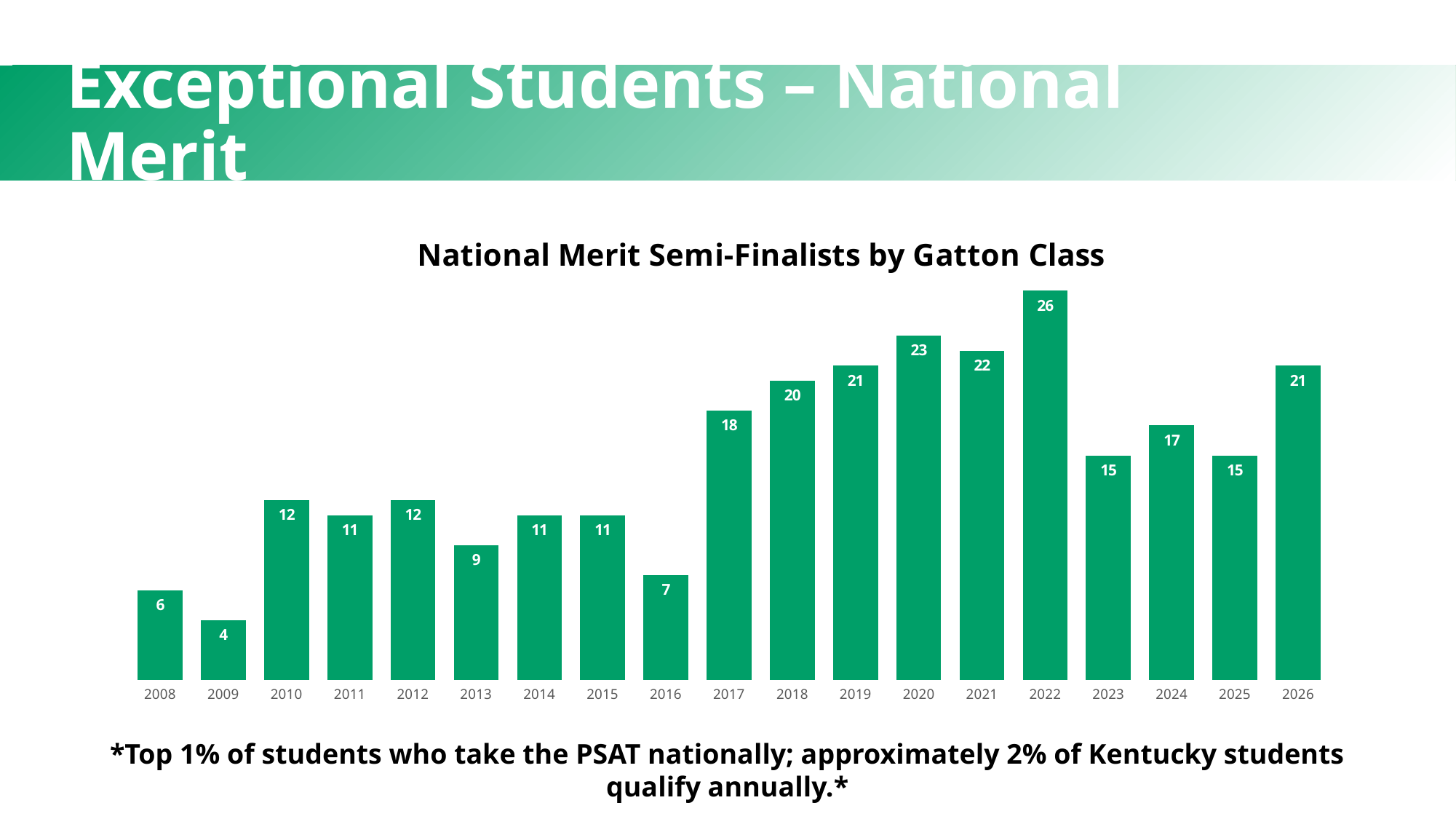
What is the number of National Merit Semi-Finalists for the 2022 Gatton class? 26 Which has a larger value, 2017 or 2024? 2017 How many National Merit Semi-Finalists are shown for the 2026 class? 21 What is the title of the chart? National Merit Semi-Finalists by Gatton Class What is the value shown for 2009? 4 What is the difference between the values for 2022 and 2023? 11 How many class years are shown on the chart? 19 How many more semi-finalists did the 2020 class have than the 2016 class? 16 Which class year has the highest number of National Merit Semi-Finalists? 2022 Which has a larger value, 2013 or 2015? 2015 What kind of chart is shown on the slide? Bar chart Which class year has the lowest number of National Merit Semi-Finalists? 2009